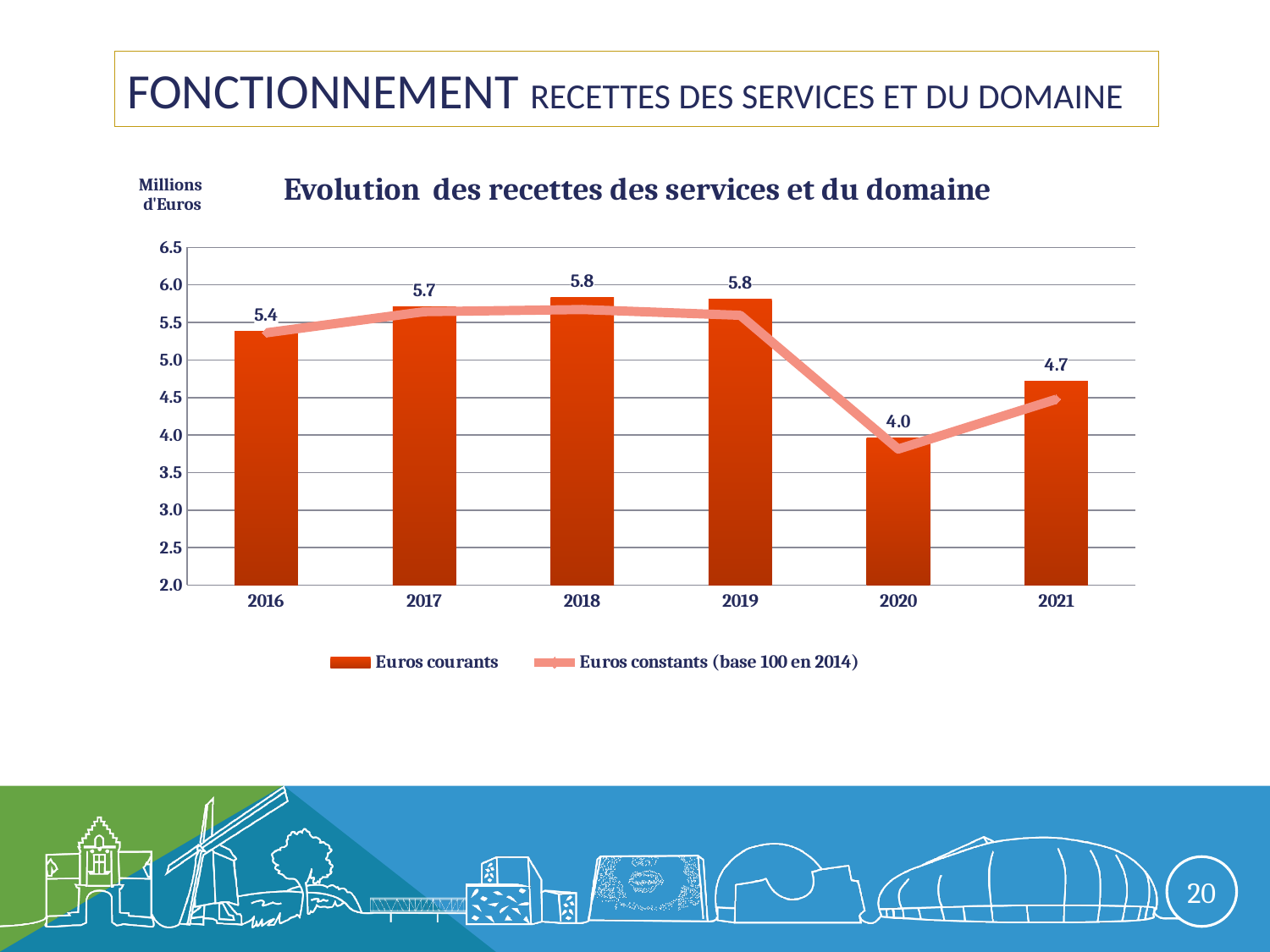
What is the value of Euros courants for 2021? 4.7 What unit is indicated for the y axis of the chart? Millions d'Euros What is the difference between the Euros courants values for 2019 and 2020? 1.8 What kind of chart is shown on the slide? A combined bar and line chart How many series does the legend list? 2 Which is larger, the Euros courants value for 2017 or for 2021? 2017 How many years are shown on the x axis? 6 What is the value of Euros courants for 2020? 4.0 Which year has the lowest value for Euros courants? 2020 Is the Euros constants (base 100 en 2014) value for 2016 greater or less than 5.0? greater Do the Euros courants values rise or fall from 2019 to 2020? fall What is the value of Euros courants for 2016? 5.4